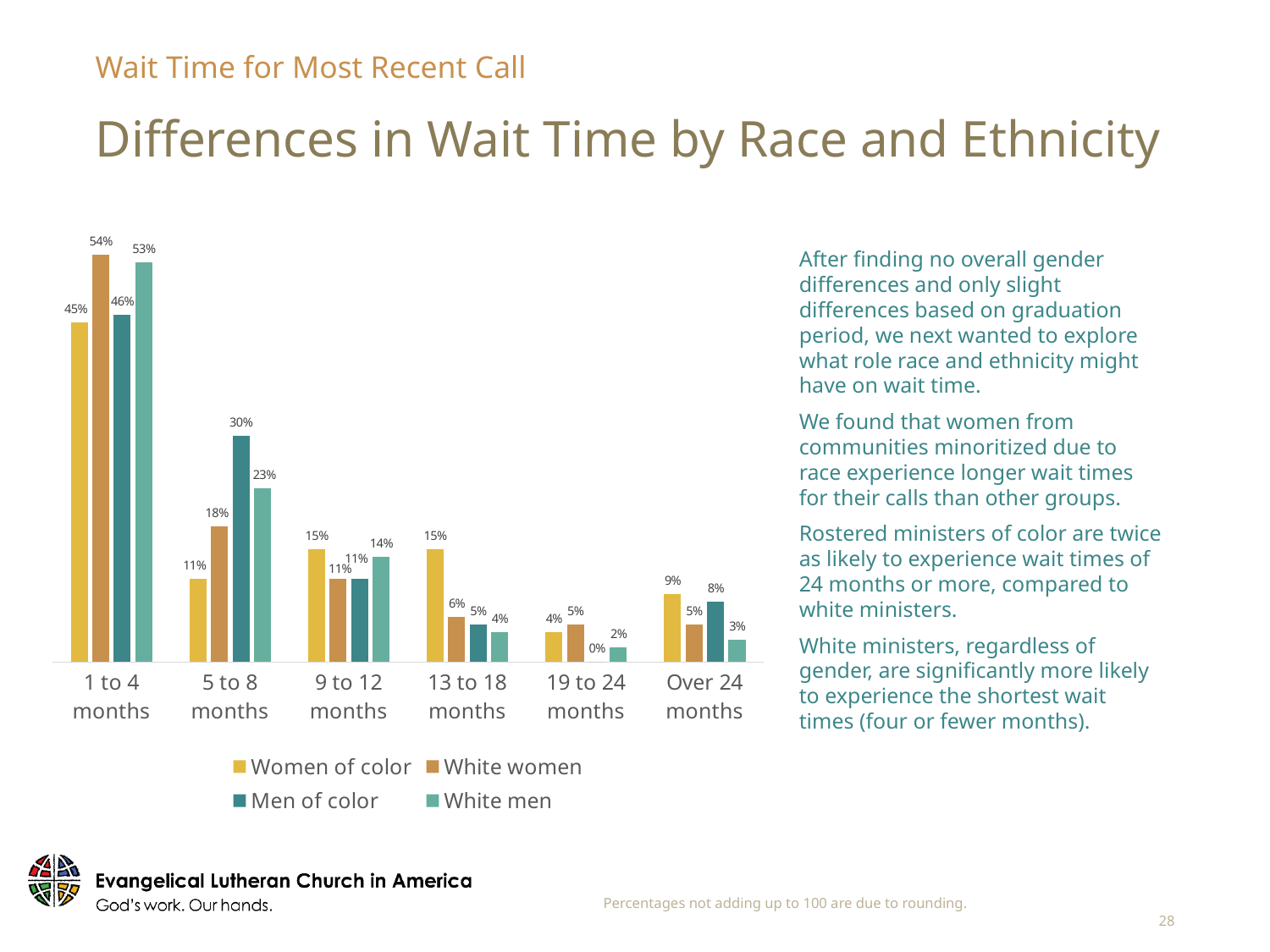
What is the value for Women of color in the 13 to 18 months category? 15% What is the value for White women in the 1 to 4 months category? 54% What is the value for White men in the Over 24 months category? 3% What is the value for Men of color in the 5 to 8 months category? 30% What is the difference between the White women and Women of color values in the 1 to 4 months category? 9% How many series does the legend list? 4 Which legend entry is shown in yellow? Women of color Which is larger in the Over 24 months category: the value for Women of color or the value for White women? Women of color How many wait-time categories are shown on the x axis? 6 Which series has the lowest value in the 19 to 24 months category? Men of color Which series has the highest value in the 5 to 8 months category? Men of color What kind of chart is shown on the slide? Bar chart